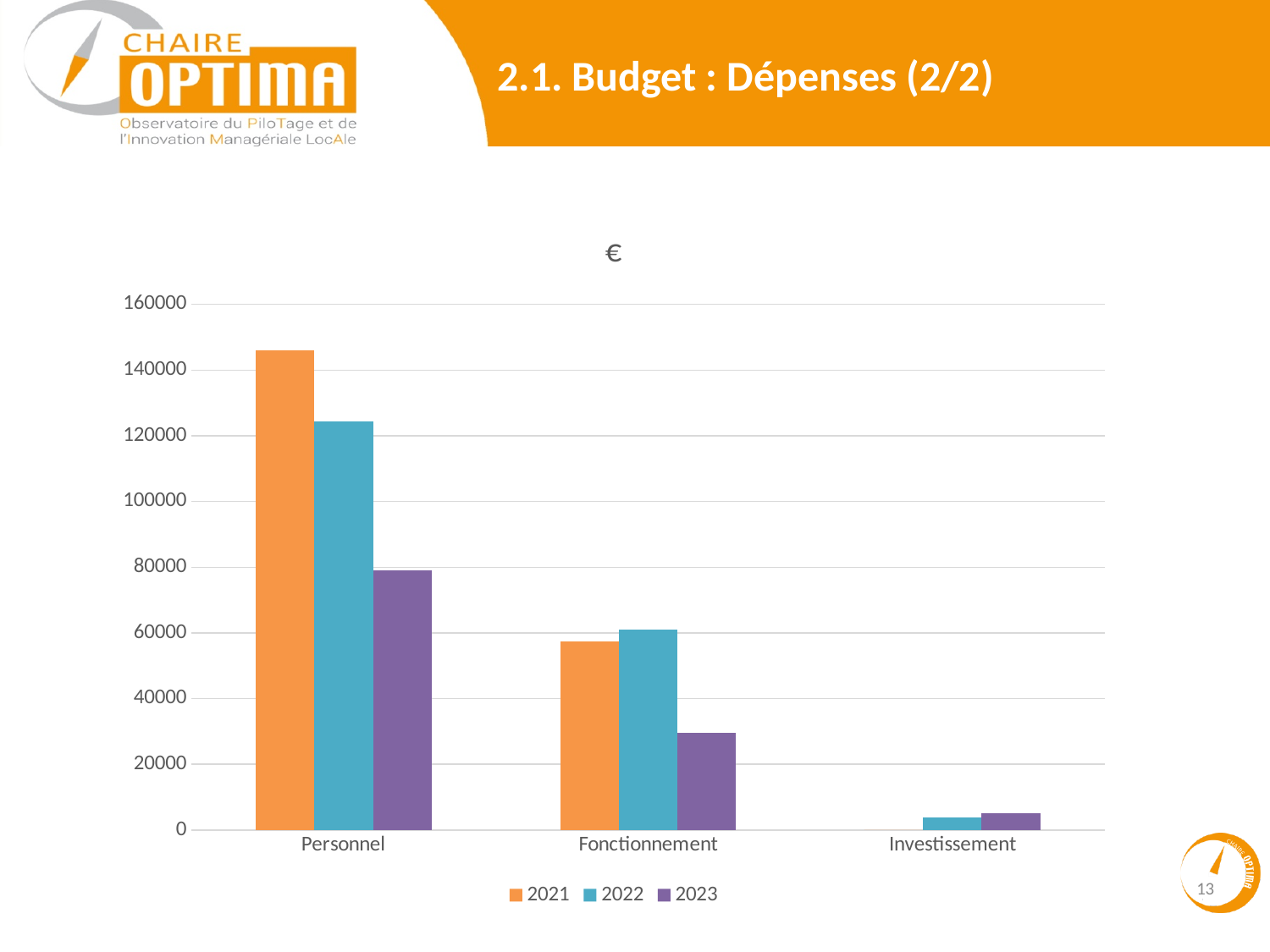
For Personnel, which series has the larger value, 2021 or 2022? 2021 Is the value for Personnel in 2021 greater or less than 140000? greater Do the values for the 2023 series rise or fall from Personnel to Investissement along the x axis? fall Which category has the lowest value for the 2023 series? Investissement Is the value for Personnel in 2023 greater or less than 100000? less How many categories are shown on the x axis of the chart? 3 Is the value for Fonctionnement in 2023 greater or less than 40000? less Which category has the highest value for the 2021 series? Personnel How many series does the chart's legend list? 3 For Fonctionnement, which series has the larger value, 2021 or 2022? 2022 What kind of chart is shown on the slide? bar chart